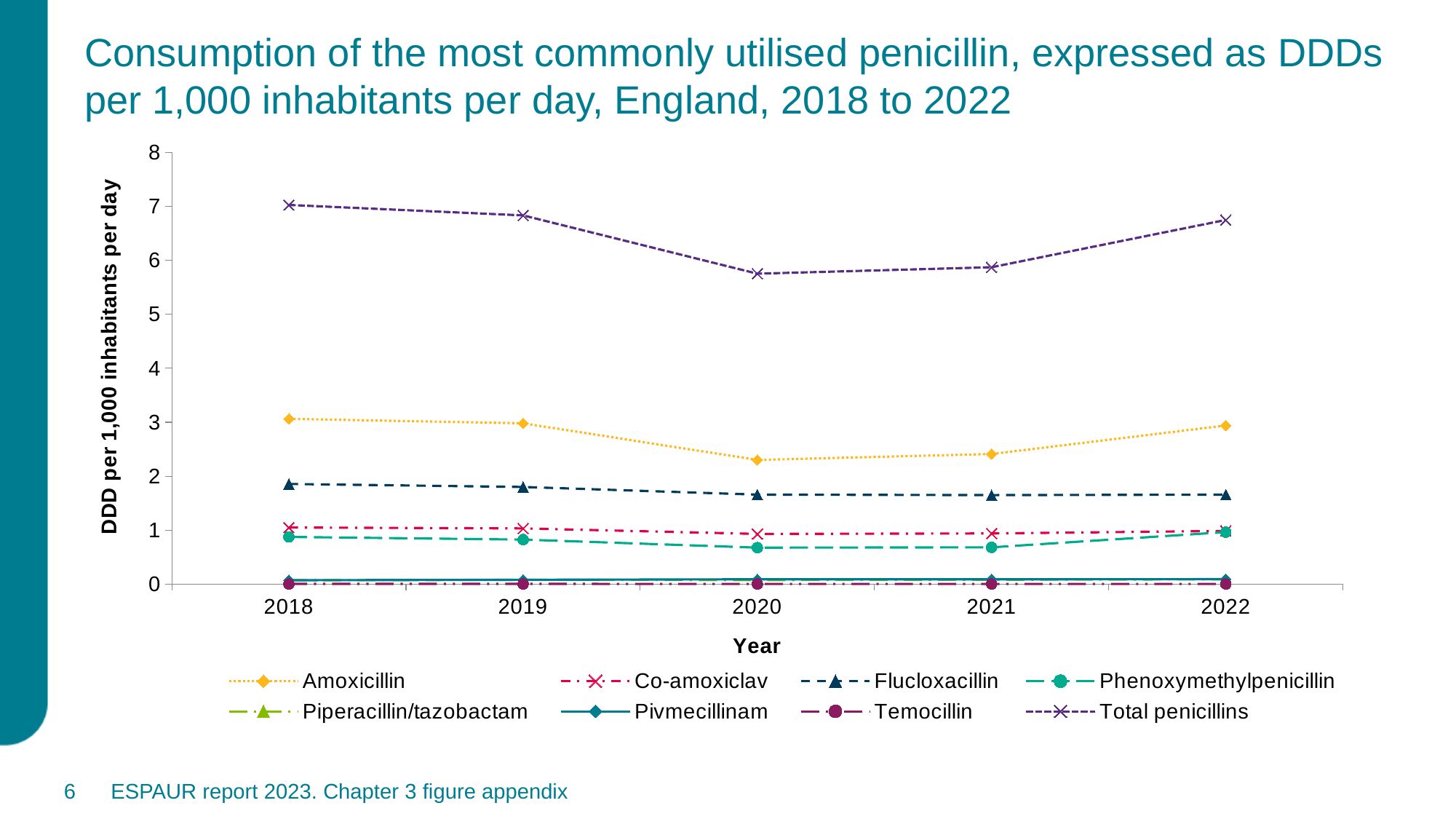
How many years are plotted along the x axis? 5 What type of chart is shown on the slide? line chart Which series has the highest value in 2018? Total penicillins In 2020, which is larger: Co-amoxiclav or Phenoxymethylpenicillin? Co-amoxiclav Does the Total penicillins line rise or fall from 2018 to 2020? fall What is the title of the x axis? Year Is the value for Flucloxacillin in 2018 greater or less than 2? less In which year is the Total penicillins value highest? 2018 Is the value for Total penicillins in 2020 greater or less than 6? less In 2022, which is larger: Amoxicillin or Flucloxacillin? Amoxicillin How many series does the legend list? 8